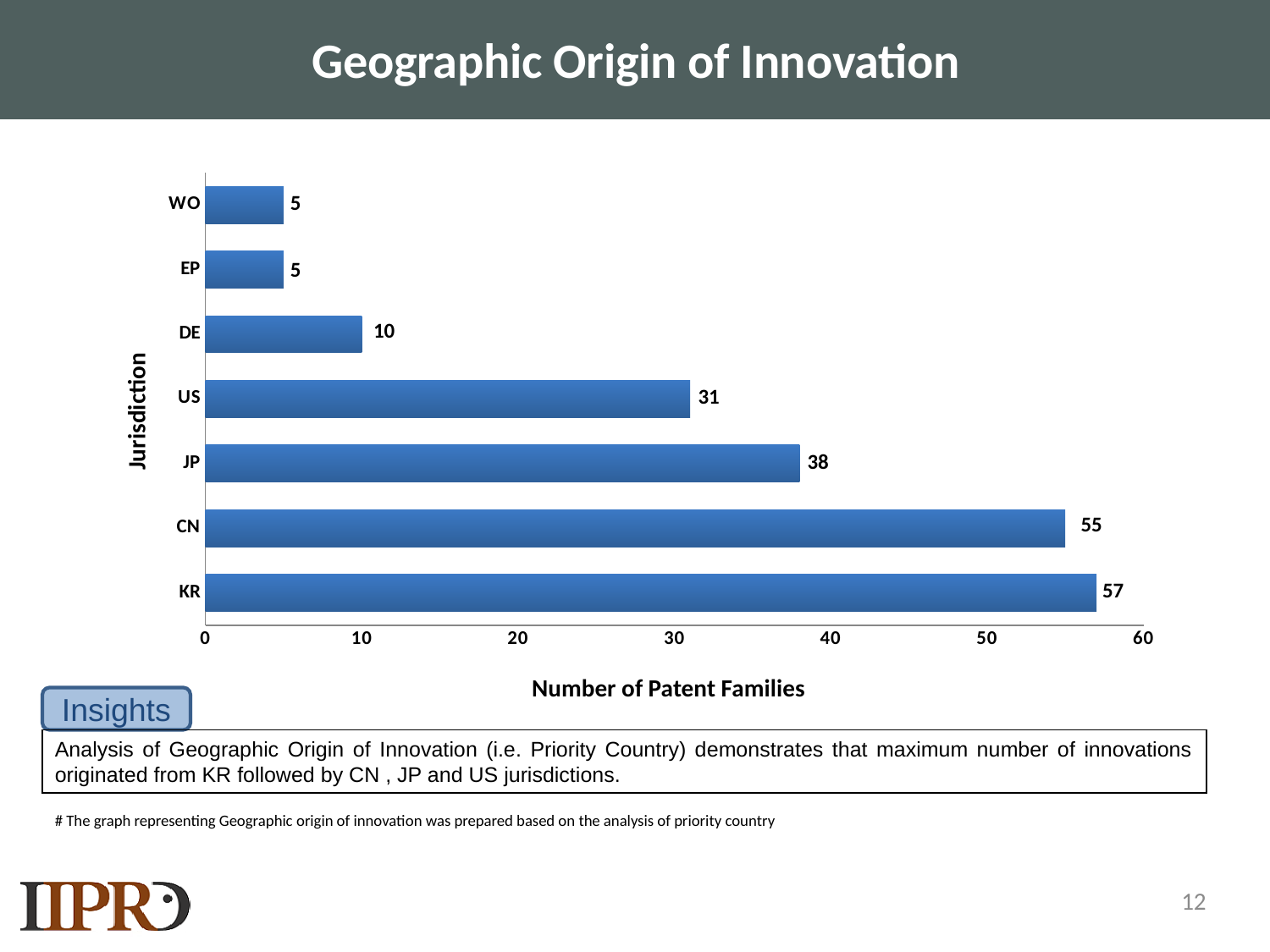
What is the number of patent families for JP? 38 Is the value for CN greater or less than 50? greater What is the label of the horizontal axis of the chart? Number of Patent Families What is the difference in patent families between KR and CN? 2 Which jurisdictions share the lowest number of patent families? WO and EP Which has more patent families, US or DE? US Which jurisdiction has the highest number of patent families? KR What is the difference in patent families between JP and US? 7 What is the number of patent families for DE? 10 How many patent families originated from KR? 57 How many jurisdictions are shown in the chart? 7 What type of chart is used to show the number of patent families by jurisdiction? Bar chart